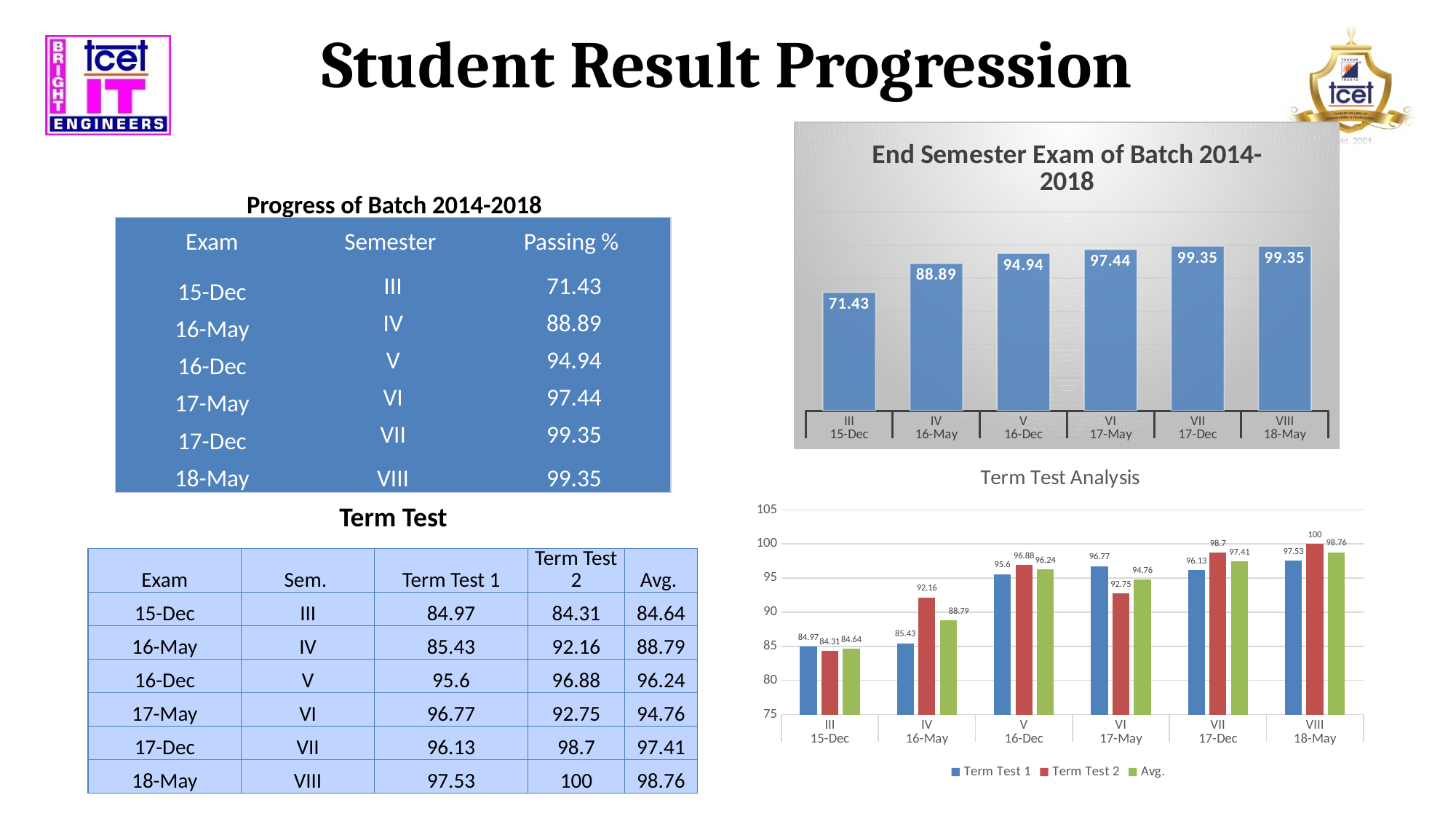
In the 'Term Test Analysis' chart, which is larger for semester VI (17-May): Term Test 1 or Term Test 2? Term Test 1 What kind of chart is the 'Term Test Analysis' chart? bar chart In the 'End Semester Exam of Batch 2014-2018' chart, how many bars are plotted? 6 In the 'End Semester Exam of Batch 2014-2018' chart, what is the value for semester III (15-Dec)? 71.43 In the 'End Semester Exam of Batch 2014-2018' chart, what is the value for semester V (16-Dec)? 94.94 In the 'End Semester Exam of Batch 2014-2018' chart, what is the difference between the values for semester IV (16-May) and semester III (15-Dec)? 17.46 In the 'Term Test Analysis' chart, what is the difference between the Term Test 2 and Term Test 1 values for semester IV (16-May)? 6.73 In the 'Term Test Analysis' chart, what is the Term Test 2 value for semester VIII (18-May)? 100 In the 'Term Test Analysis' chart, what is the Avg. value for semester IV (16-May)? 88.79 In the 'End Semester Exam of Batch 2014-2018' chart, which semester has the lowest value? III (15-Dec) How many series does the legend of the 'Term Test Analysis' chart list? 3 In the 'End Semester Exam of Batch 2014-2018' chart, do the values rise or fall from semester III to semester VI? rise